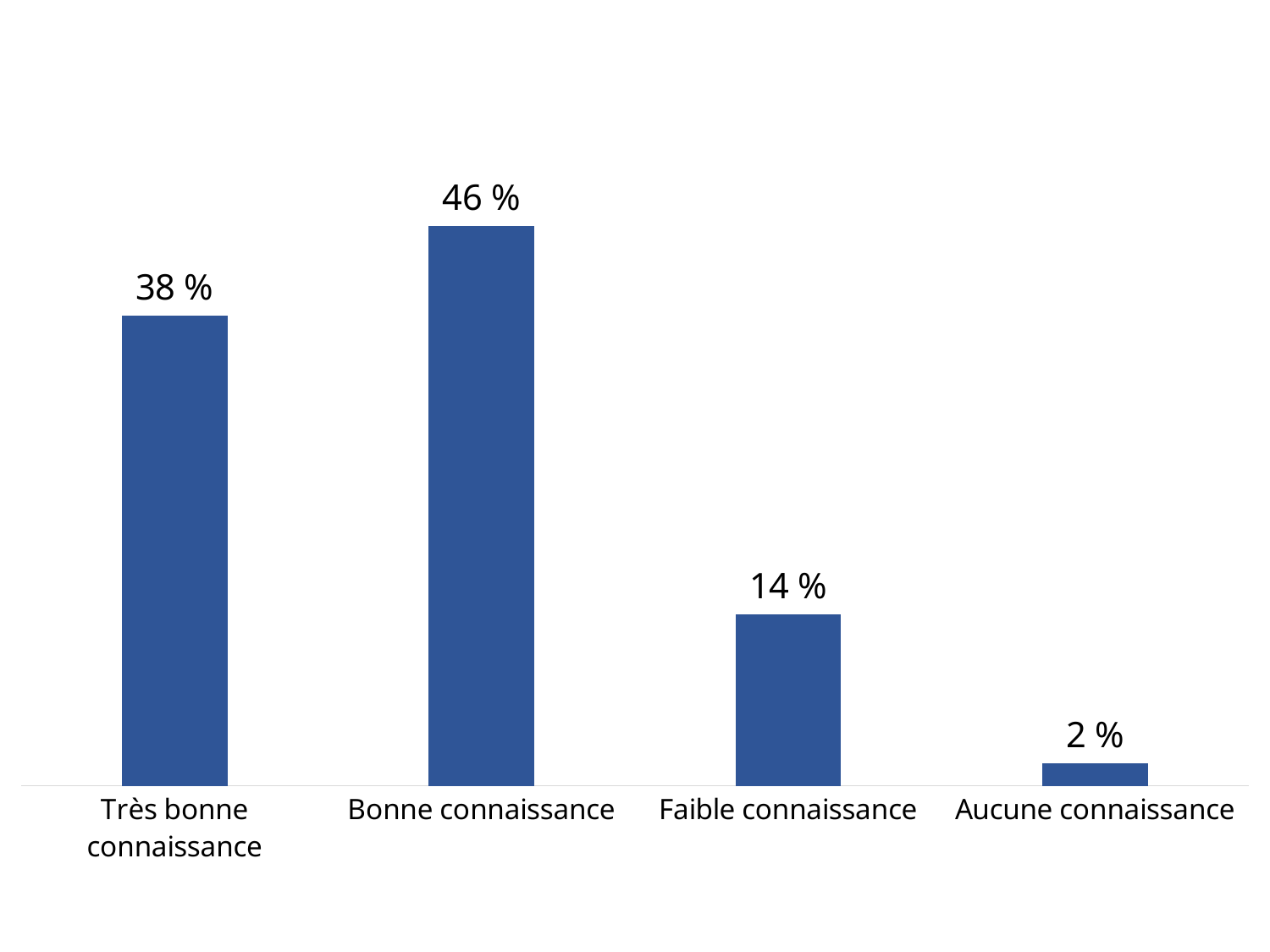
What is the value for Faible connaissance? 14 % What is the value for Aucune connaissance? 2 % What is the difference between the values for Faible connaissance and Aucune connaissance? 12 % What is the value for Bonne connaissance? 46 % What colour are the bars in the chart? Blue What is the value for Très bonne connaissance? 38 % Which category has the highest value? Bonne connaissance How many categories are shown in the chart? 4 Which category has the lowest value? Aucune connaissance What is the difference between the values for Bonne connaissance and Très bonne connaissance? 8 % What kind of chart is shown on the slide? Bar chart Which is larger, the value for Très bonne connaissance or the value for Faible connaissance? Très bonne connaissance